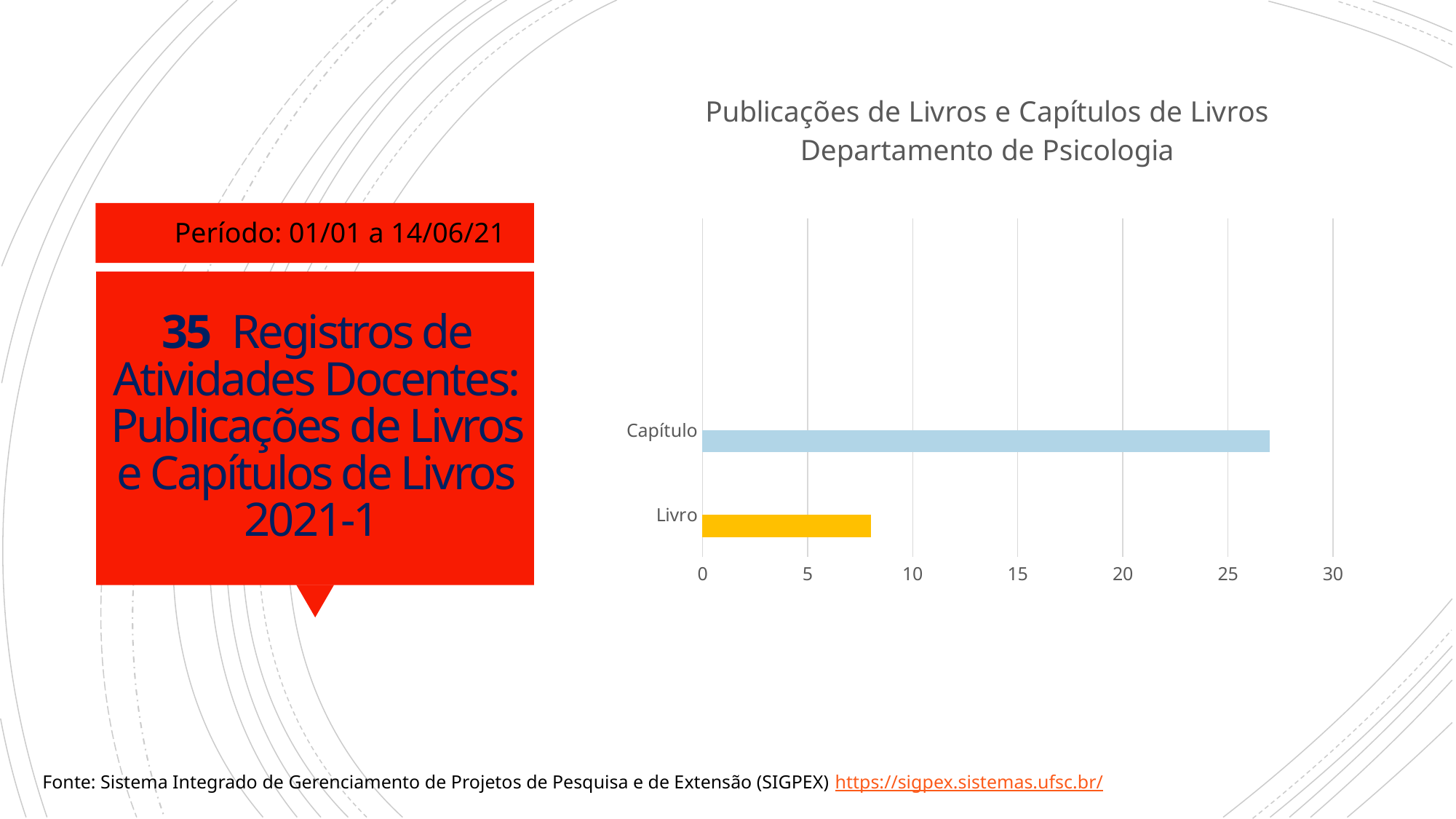
What is the title of the chart? Publicações de Livros e Capítulos de Livros Departamento de Psicologia Is the value for Capítulo greater or less than 30? less Which category has the lowest value in the chart? Livro Which is larger, the value for Capítulo or the value for Livro? Capítulo Is the value for Capítulo greater or less than 25? greater What colour is the bar for Livro? yellow Which category has the highest value in the chart? Capítulo How many categories are plotted in the chart? 2 Is the value for Livro greater or less than 5? greater What kind of chart is shown on the slide? bar chart